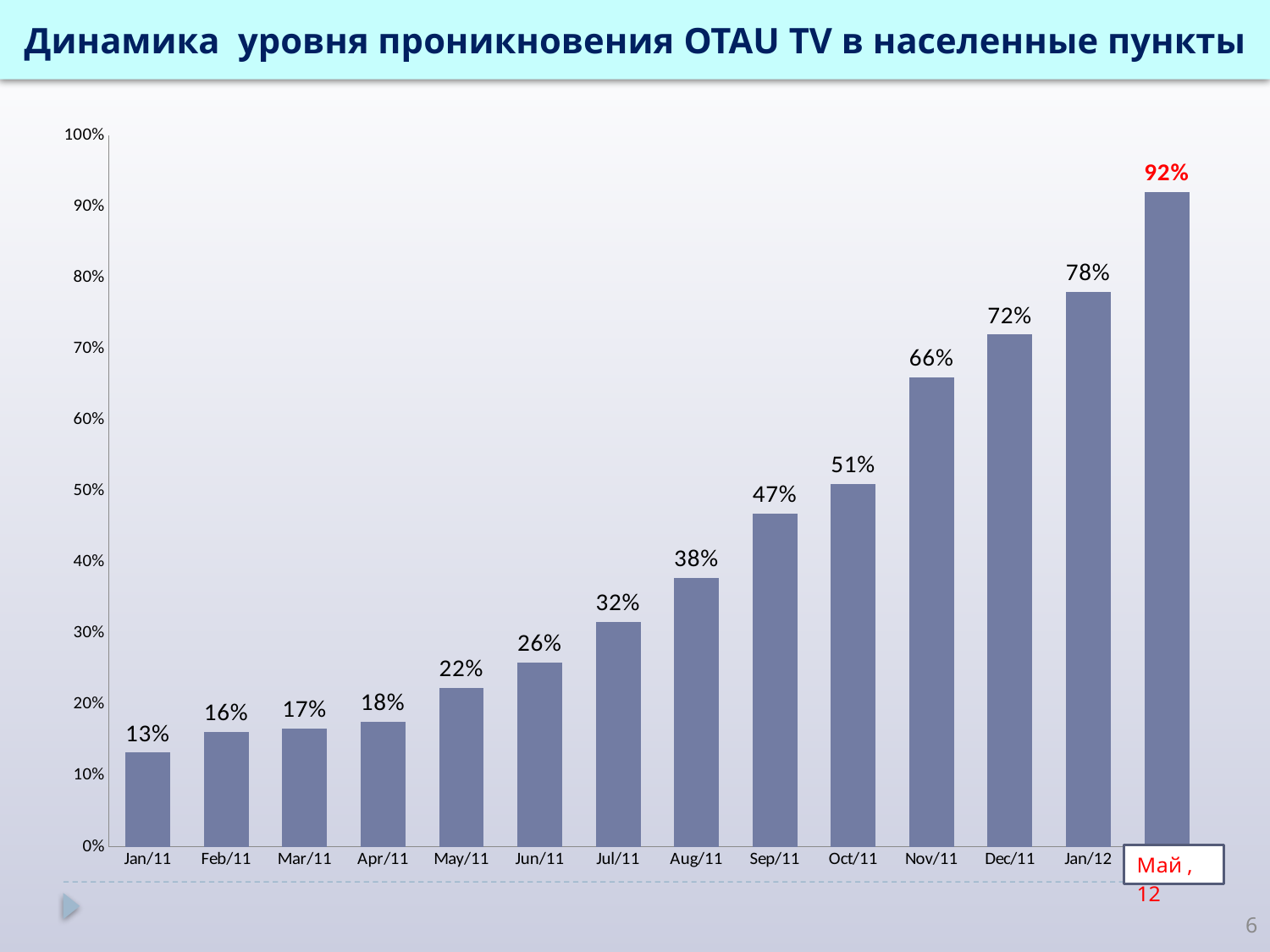
How many bars are shown in the chart? 14 What is the value for Jul/11? 32% What is the value for Jan/11? 13% Which category has the highest value? Май, 12 What is the difference between the values for Jan/12 and Jan/11? 65% What is the value for the last bar, labelled Май, 12? 92% Which is larger, the value for Sep/11 or the value for Aug/11? Sep/11 What is the value for Dec/11? 72% Do the values rise or fall from Jan/11 to Май, 12? Rise What is the difference between the values for Nov/11 and Oct/11? 15% What kind of chart is shown on the slide? Bar chart Which category has the lowest value? Jan/11